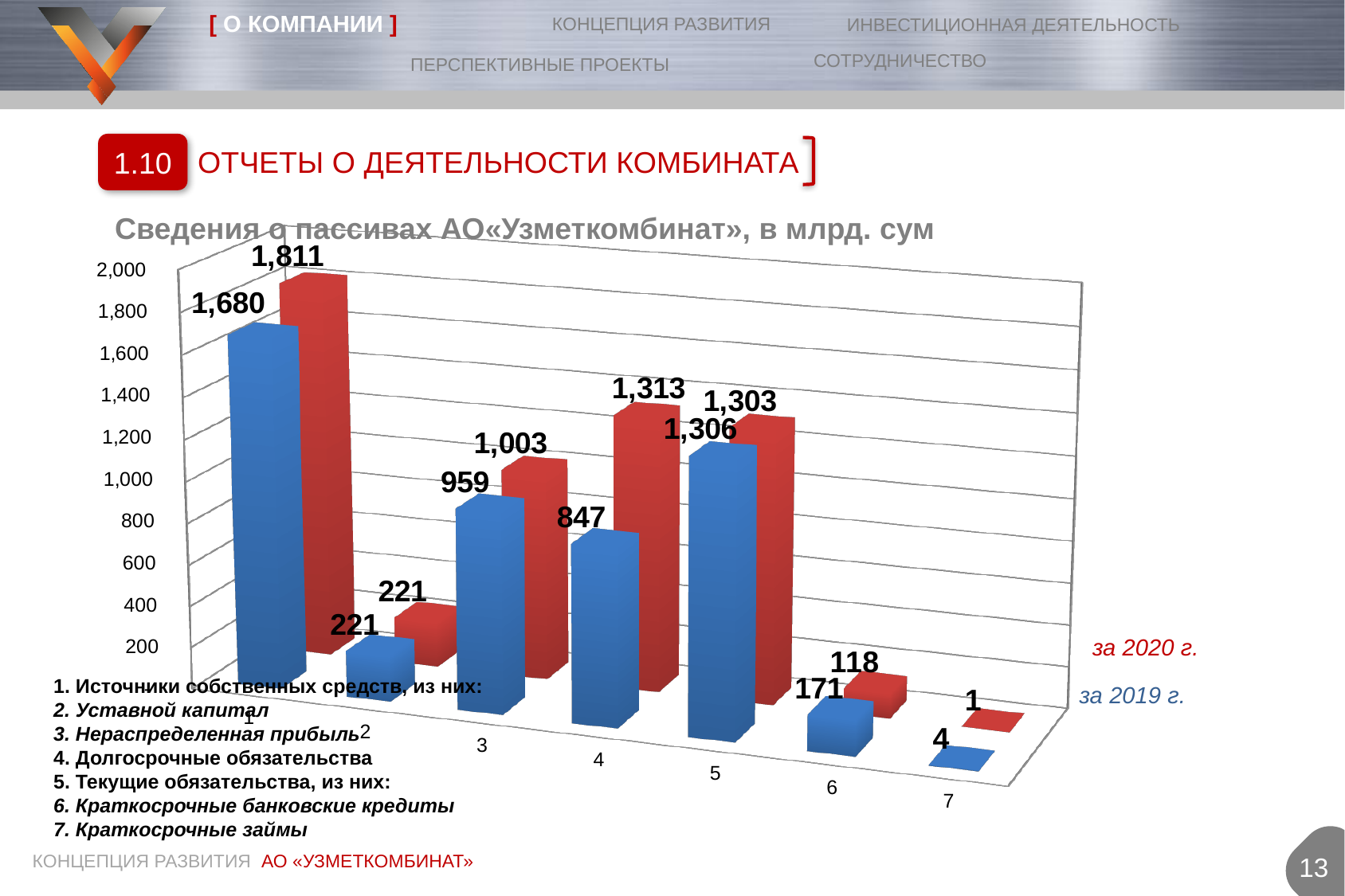
What is the value for category 6 in the 'за 2019 г.' series? 171 What is the difference between the 'за 2020 г.' and 'за 2019 г.' values for category 4? 466 What is the value for category 1 in the 'за 2020 г.' series? 1,811 How many series does the legend list? 2 What kind of chart is shown on the slide? bar chart Which category has the highest value in the 'за 2020 г.' series? 1 How many categories are shown on the x axis? 7 Which category has the lowest value in the 'за 2019 г.' series? 7 What is the value for category 1 in the 'за 2019 г.' series? 1,680 For category 6, which series has the larger value, 'за 2019 г.' or 'за 2020 г.'? за 2019 г. What is the value for category 4 in the 'за 2020 г.' series? 1,313 What is the title of the chart? Сведения о пассивах АО«Узметкомбинат», в млрд. сум